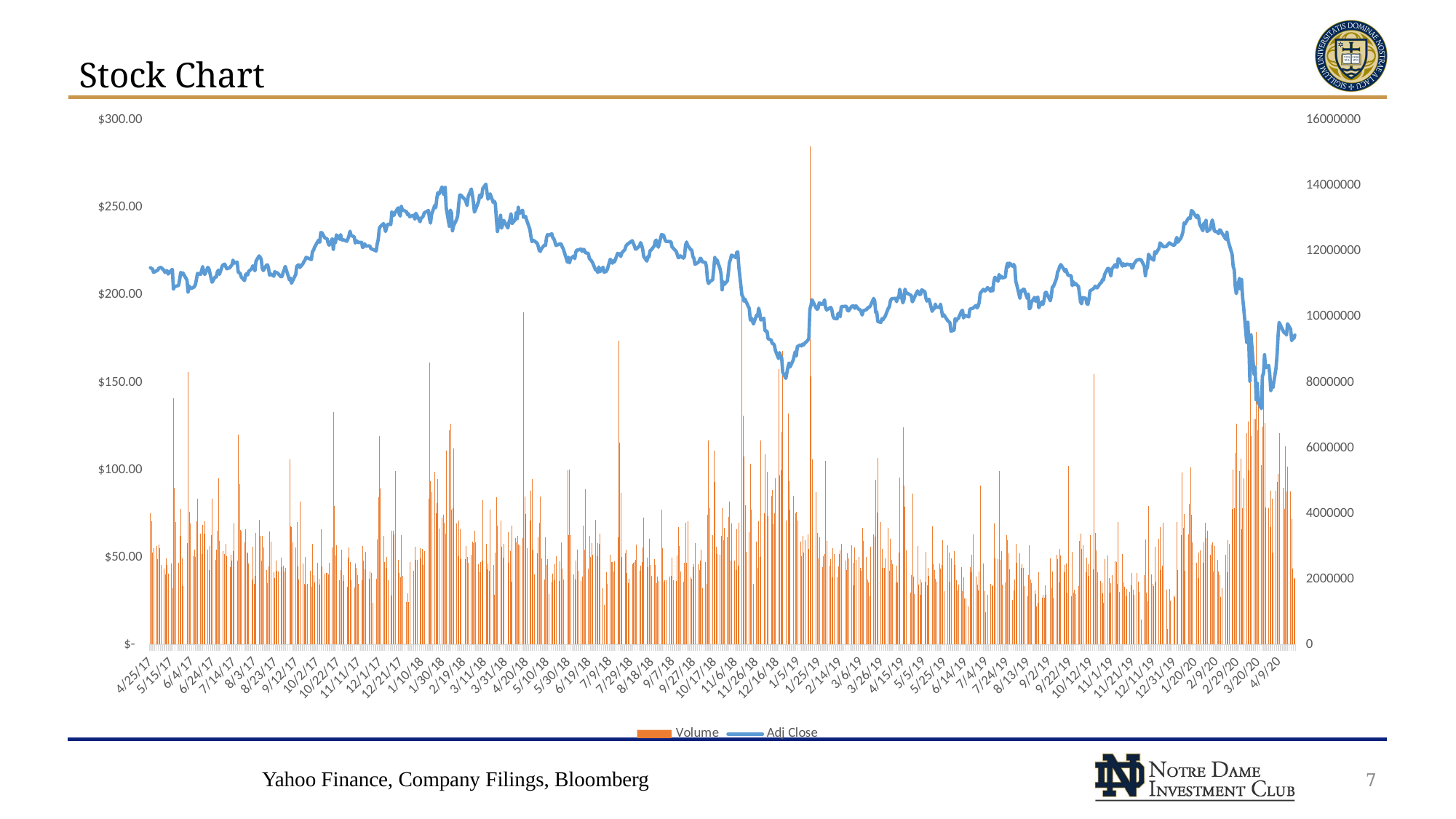
Is the Adj Close value around 4/25/17 greater or less than $200.00? greater What kind of chart is shown on the slide? A combination bar and line chart How many series does the legend list? 2 Does the Adj Close line rise or fall between 4/25/17 and 2/19/18? rise Is the Adj Close value around 2/19/18 greater or less than $250.00? greater What are the two series named in the legend? Volume and Adj Close Is the Adj Close value around 12/16/18 greater or less than $200.00? less Does the Adj Close line rise or fall between 1/20/20 and 3/20/20? fall Is the Adj Close value around 1/20/20 higher or lower than around 3/20/20? higher Which series is plotted as a line? Adj Close